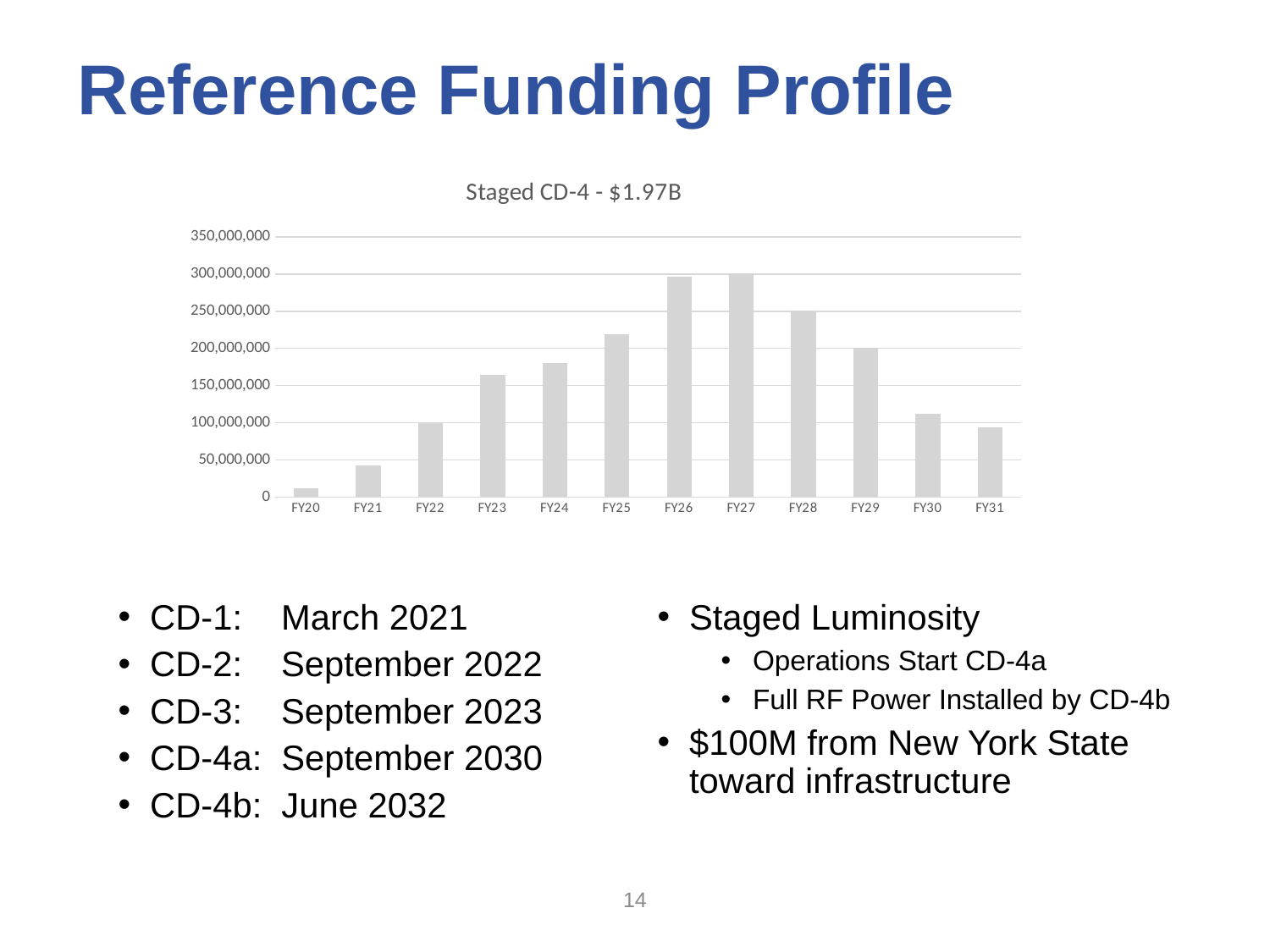
Is the value for FY21 greater or less than 50,000,000? less What is the title of the chart? Staged CD-4 - $1.97B Is the value for FY25 greater or less than 200,000,000? greater Is the value for FY23 greater or less than 150,000,000? greater What kind of chart is shown on the slide? bar chart Do the values rise or fall from FY20 to FY27? rise How many fiscal years are plotted on the chart? 12 Which is larger, the value for FY28 or the value for FY29? FY28 Which fiscal year has the lowest value on the chart? FY20 Which is larger, the value for FY23 or the value for FY24? FY24